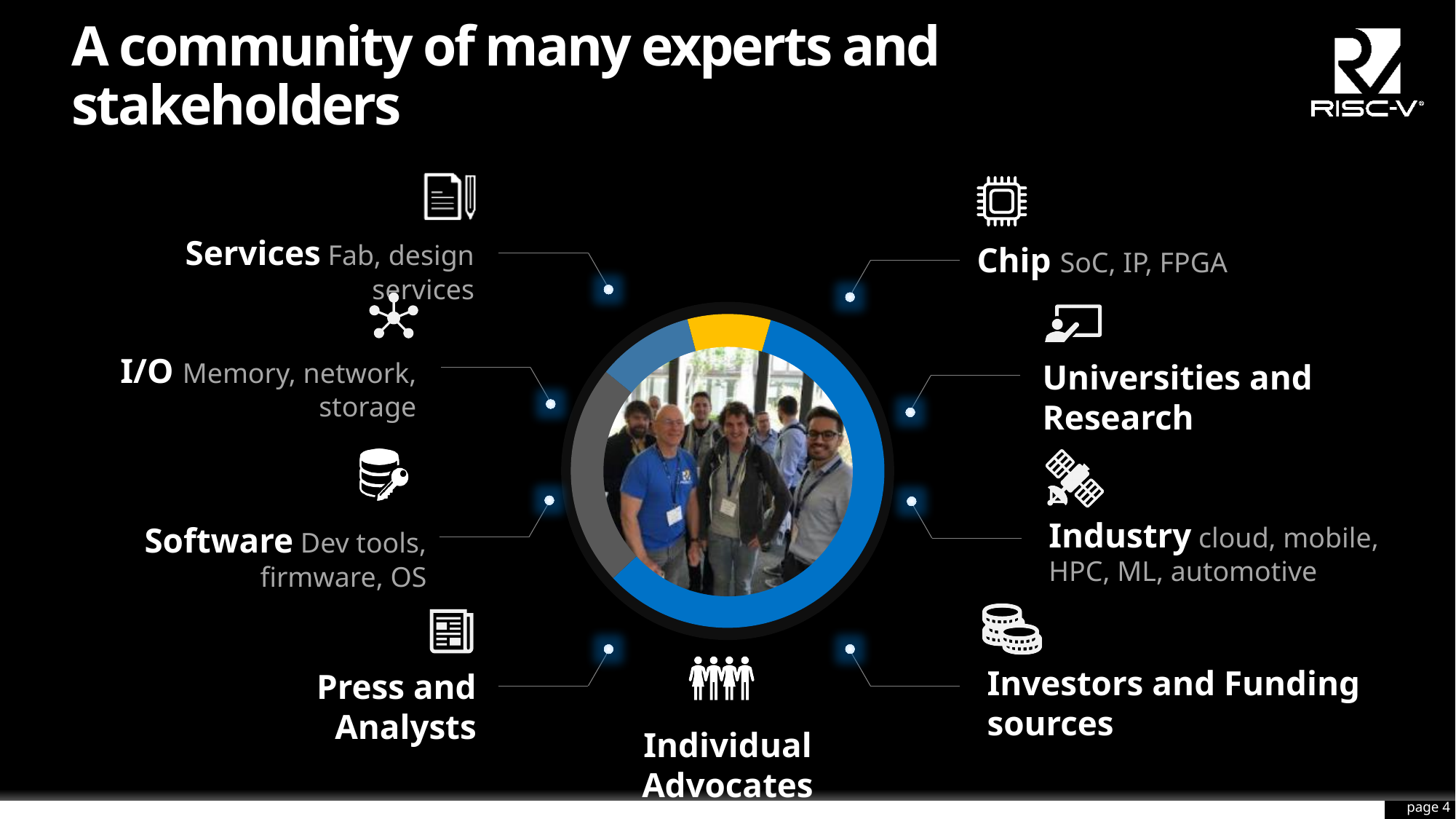
Which colour segment of the ring around the central photo is the largest? blue How many coloured segments does the ring around the central photo have? 4 Is the blue segment of the ring around the central photo larger or smaller than the grey segment? larger Does the ring chart around the central photo show any data labels or a legend? No Which colour segment of the ring around the central photo is the smallest? yellow What kind of chart is the ring around the photo in the centre of the slide? donut chart